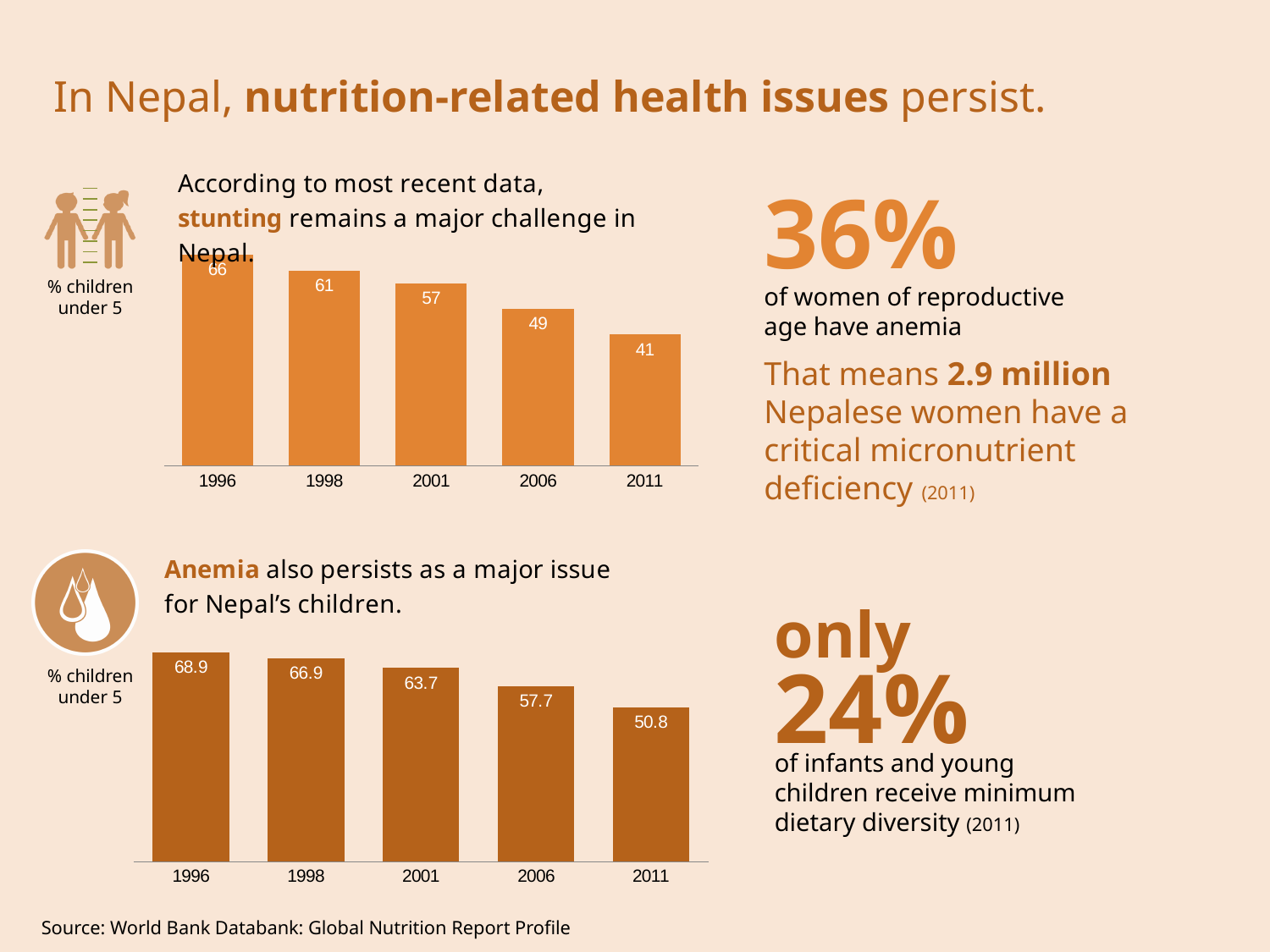
In the anemia chart (bottom), what is the difference between the 2006 and 2011 values? 6.9 In the stunting chart (top), what is the value for 2006? 49 In the anemia chart (bottom), what is the value for 2011? 50.8 In the anemia chart (bottom), which year has the lowest value? 2011 In the stunting chart (top), do the values rise or fall from 1996 to 2011? Fall What kind of chart is the anemia chart (bottom)? Bar chart In the anemia chart (bottom), what is the value for 1996? 68.9 In the anemia chart (bottom), which is larger, the value for 1998 or the value for 2006? 1998 How many years are shown in the stunting chart (top)? 5 In the stunting chart (top), what is the value for 2011? 41 In the stunting chart (top), which year has the highest value? 1996 In the stunting chart (top), what is the difference between the 1998 and 2001 values? 4